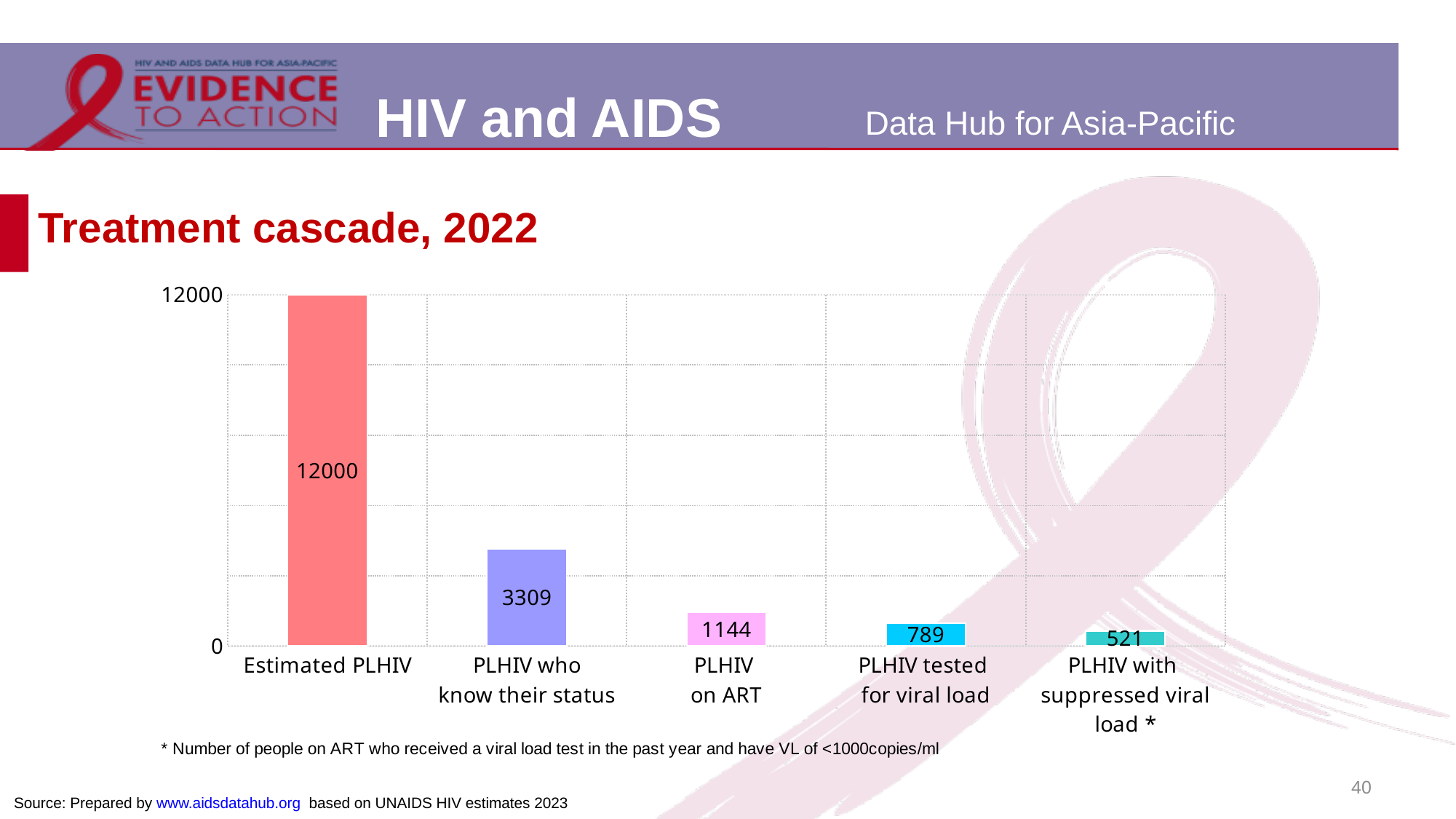
What is the value for PLHIV who know their status? 3309 What is the difference between PLHIV on ART and PLHIV tested for viral load? 355 Which category has the lowest value? PLHIV with suppressed viral load What is the difference between Estimated PLHIV and PLHIV who know their status? 8691 What is the value for PLHIV with suppressed viral load? 521 What is the value for PLHIV tested for viral load? 789 What is the value for PLHIV on ART? 1144 What kind of chart is shown on the slide? Bar chart What is the value for Estimated PLHIV? 12000 How many categories are shown in the chart? 5 Which is larger, PLHIV on ART or PLHIV with suppressed viral load? PLHIV on ART Which category has the highest value? Estimated PLHIV